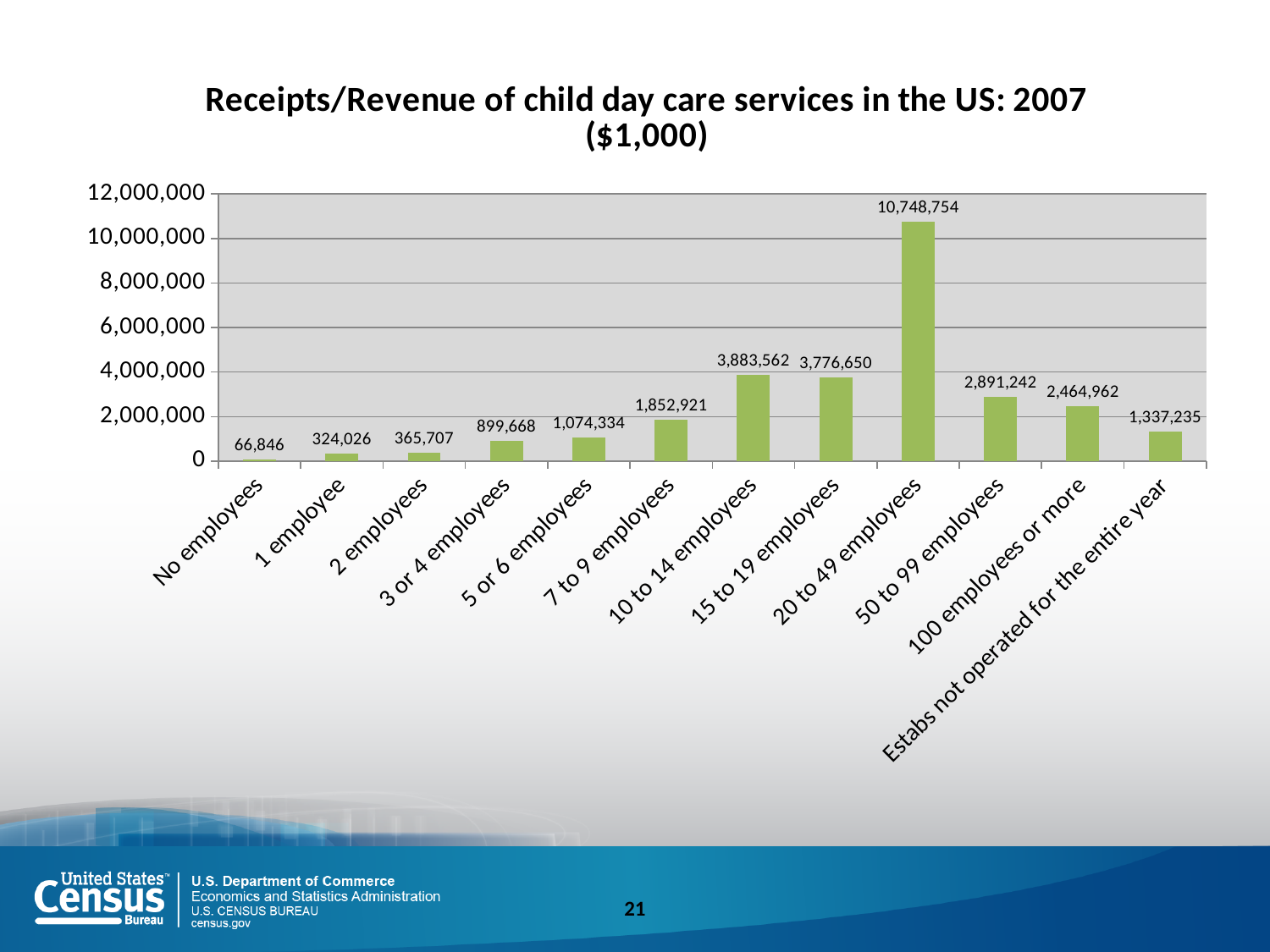
What is the value for Estabs not operated for the entire year? 1,337,235 What kind of chart is shown on the slide? Bar chart Which category has the highest value? 20 to 49 employees What is the value for No employees? 66,846 What is the difference between the values for 20 to 49 employees and 10 to 14 employees? 6,865,192 Is the value for 15 to 19 employees greater or less than 2,000,000? greater Which category has the lowest value? No employees What is the value for 20 to 49 employees? 10,748,754 How many categories are shown on the x axis? 12 Which is larger, the value for 50 to 99 employees or the value for 100 employees or more? 50 to 99 employees What is the difference between the values for 50 to 99 employees and 100 employees or more? 426,280 What is the value for 7 to 9 employees? 1,852,921